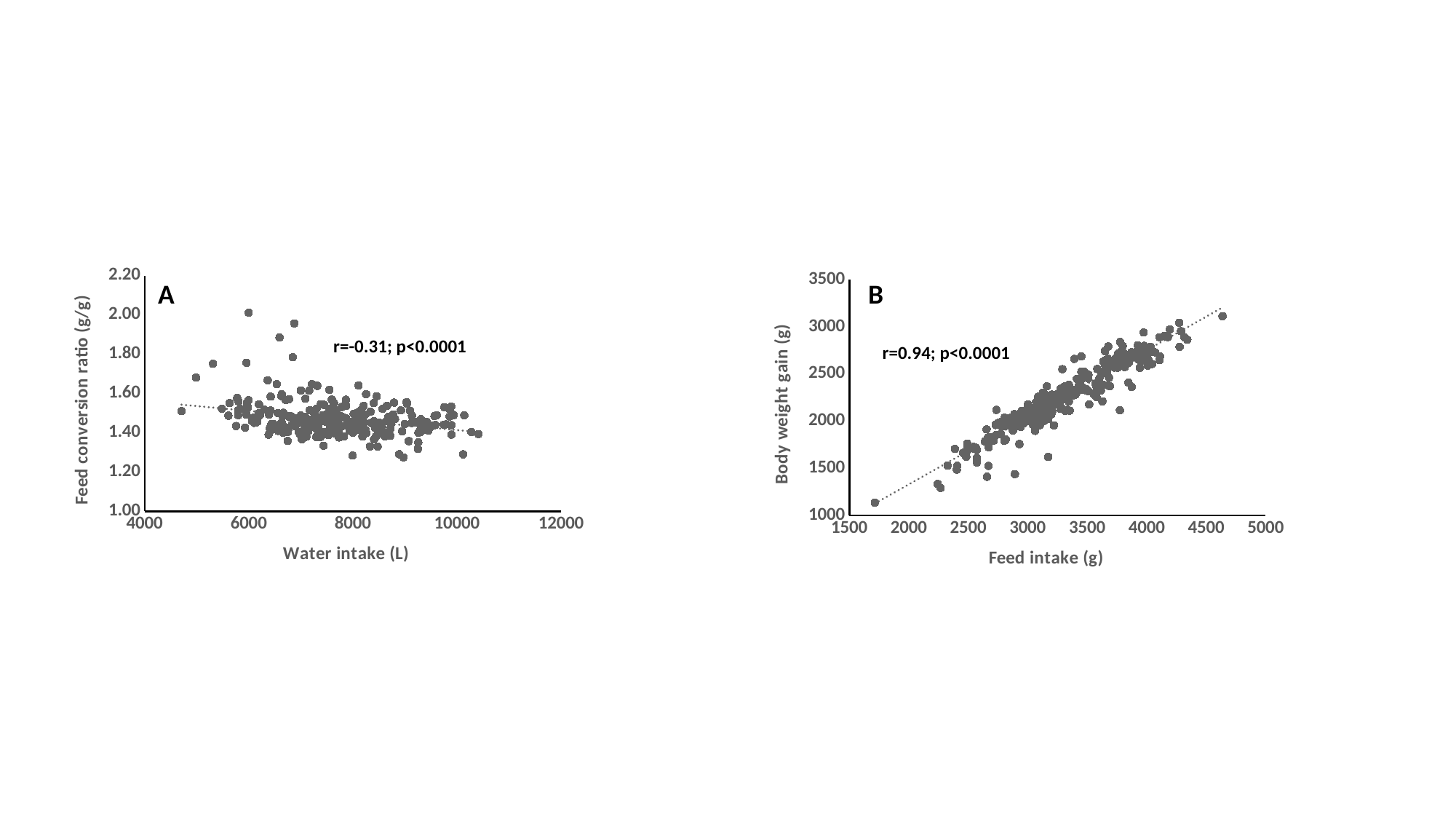
How many charts are shown on the slide? 2 In chart B, is the body weight gain of the point with the lowest feed intake greater or less than 1500? less In chart A, is the highest feed conversion ratio plotted greater or less than 1.80? greater What kind of chart is chart B, on the right of the slide? scatter chart What kind of chart is chart A, on the left of the slide? scatter chart What correlation coefficient and p-value are printed on chart B? r=0.94; p<0.0001 In chart B, is the body weight gain of the point with the highest feed intake greater or less than 3000? greater What correlation coefficient and p-value are printed on chart A? r=-0.31; p<0.0001 Which chart shows the stronger correlation between its variables, chart A or chart B? chart B In chart A, does the trend line for feed conversion ratio rise or fall as water intake increases along the x axis? fall In chart B, do the body weight gain values rise or fall as feed intake increases along the x axis? rise